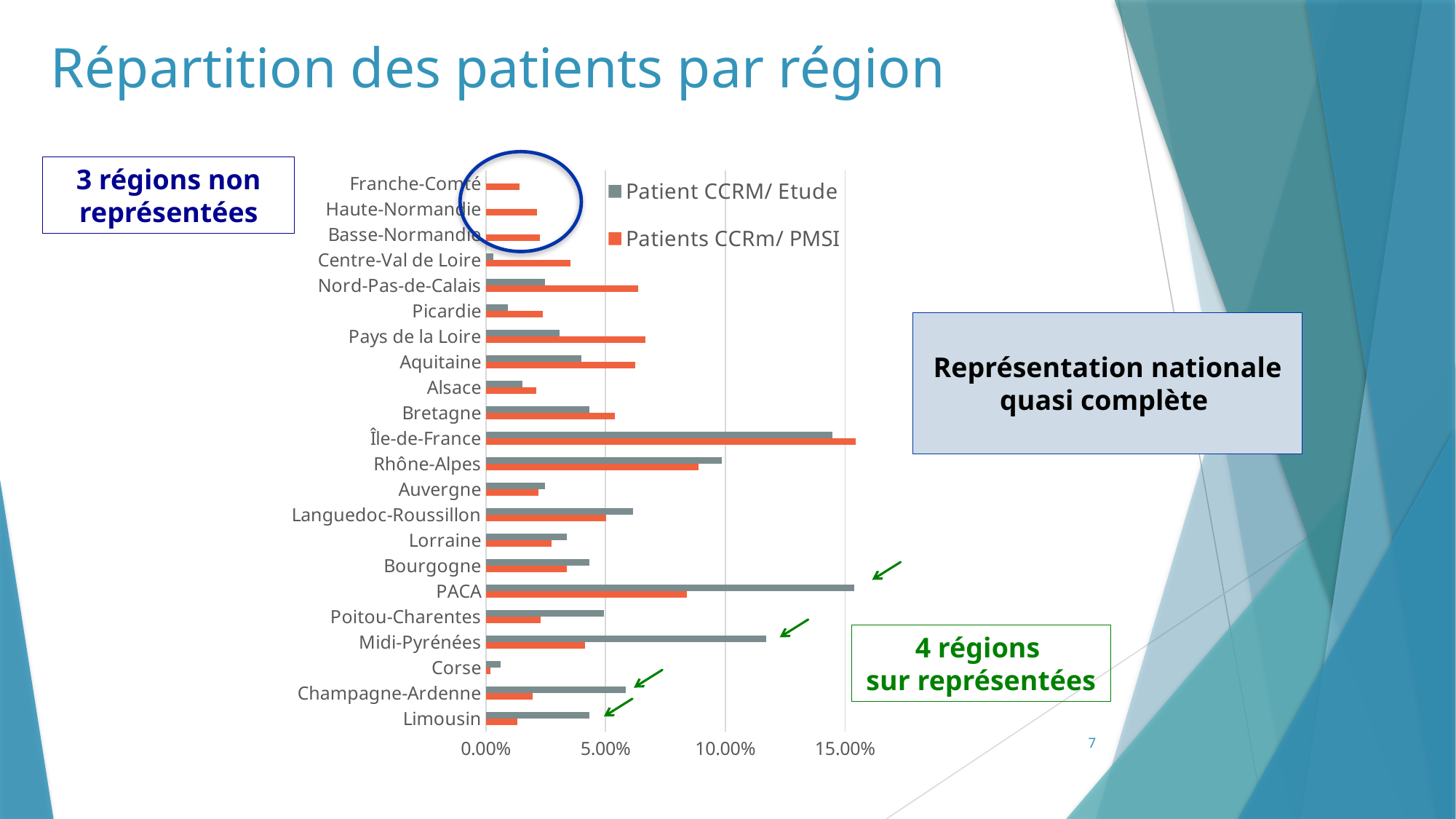
For Nord-Pas-de-Calais, which series has the larger value: Patient CCRM/ Etude or Patients CCRm/ PMSI? Patients CCRm/ PMSI For Midi-Pyrénées, which series has the larger value: Patient CCRM/ Etude or Patients CCRm/ PMSI? Patient CCRM/ Etude What is the title of the slide containing the chart? Répartition des patients par région Which colour represents the Patients CCRm/ PMSI series in the chart? Orange How many series does the chart legend list? 2 Which region has the highest value for the Patients CCRm/ PMSI series? Île-de-France Which region has the lowest value for the Patients CCRm/ PMSI series? Corse Is the Patient CCRM/ Etude value for Midi-Pyrénées greater or less than 10.00%? greater What kind of chart is shown on the slide? Bar chart How many regions are listed on the chart's vertical axis? 22 Is the Patients CCRm/ PMSI value for Nord-Pas-de-Calais greater or less than 5.00%? greater Is the Patient CCRM/ Etude value for Limousin greater or less than 5.00%? less